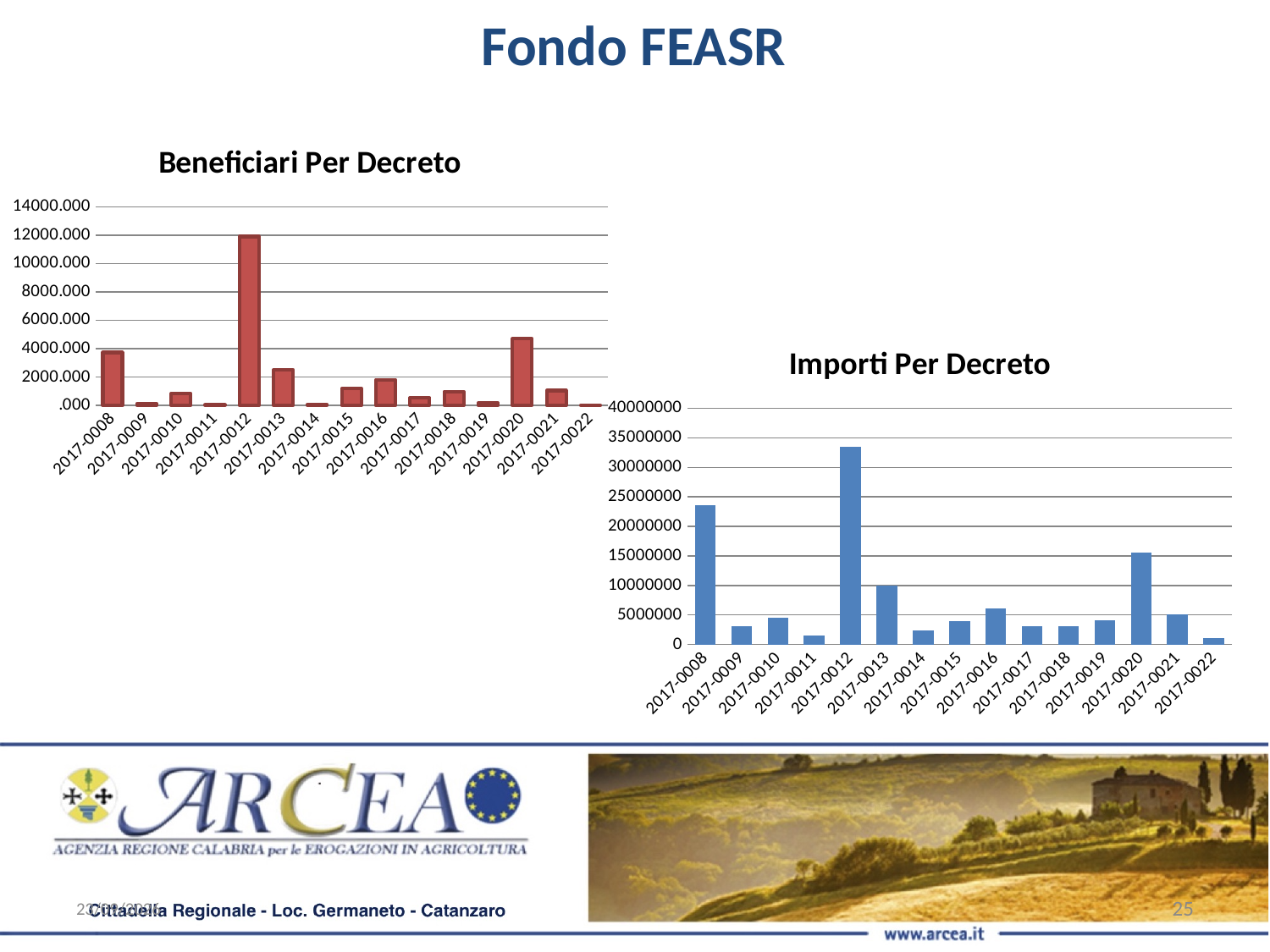
What colour are the bars in the "Importi Per Decreto" chart? blue In the "Importi Per Decreto" chart, how many decrees (categories) are shown on the x axis? 15 What kind of chart is "Importi Per Decreto"? bar chart In the "Importi Per Decreto" chart, is the value for 2017-0016 greater or less than 10000000? less In the "Importi Per Decreto" chart, is the value for 2017-0012 greater or less than 30000000? greater In the "Beneficiari Per Decreto" chart, which decree has the highest value? 2017-0012 In the "Beneficiari Per Decreto" chart, is the value for 2017-0012 greater or less than 10000.000? greater In the "Beneficiari Per Decreto" chart, how many decrees (categories) are shown on the x axis? 15 What kind of chart is "Beneficiari Per Decreto"? bar chart In the "Importi Per Decreto" chart, which is larger, the value for 2017-0008 or the value for 2017-0020? 2017-0008 In the "Importi Per Decreto" chart, which decree has the highest value? 2017-0012 In the "Beneficiari Per Decreto" chart, which is larger, the value for 2017-0008 or the value for 2017-0013? 2017-0008